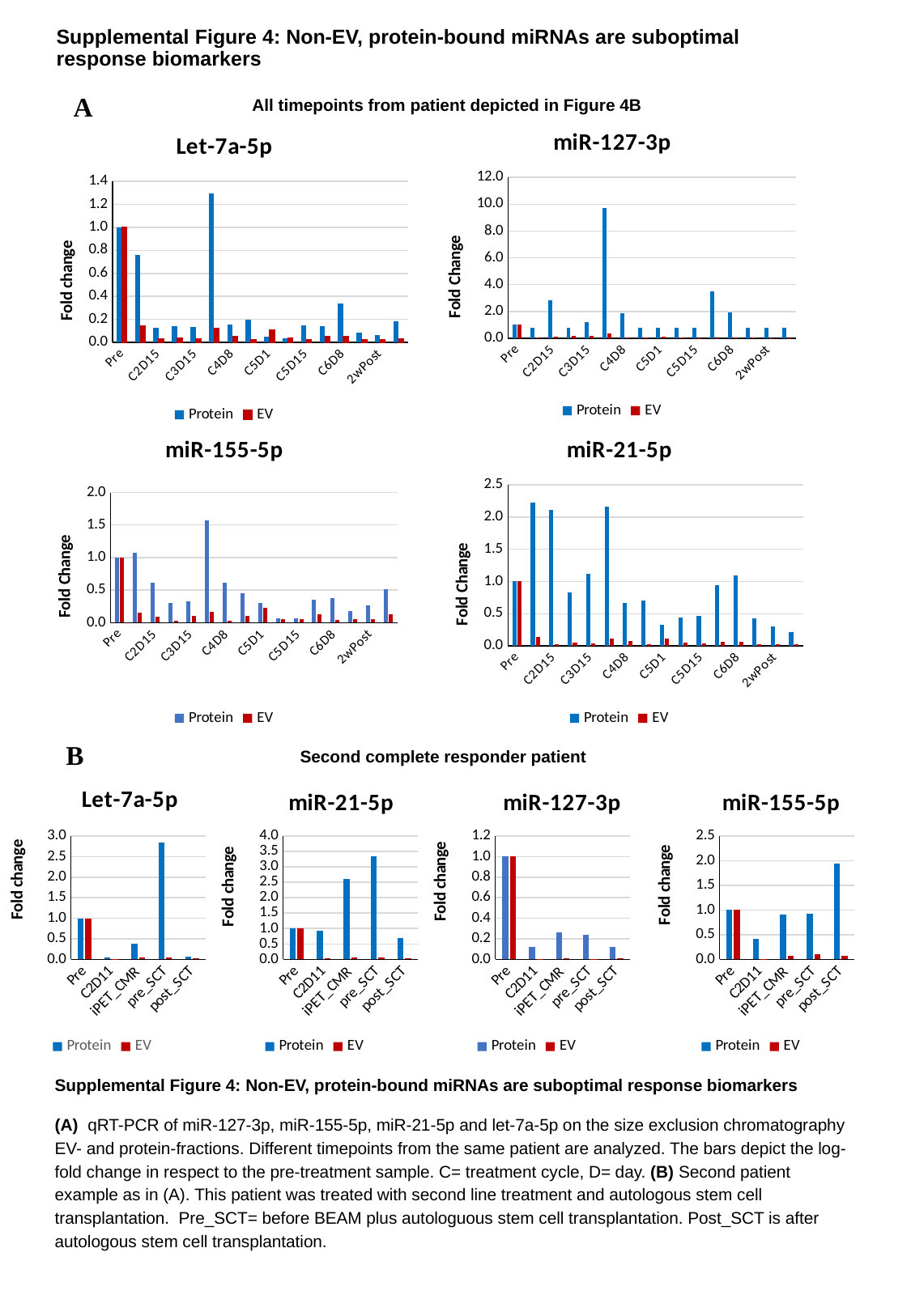
What are the two legend entries in the miR-155-5p chart in panel A? Protein and EV How many timepoint categories are shown on the x axis of the miR-127-3p chart in panel B? 5 In the Let-7a-5p chart in panel B, what is the Protein value at Pre? 1.0 In the miR-21-5p chart in panel B, which timepoint has the highest Protein value? pre_SCT In the miR-21-5p chart in panel B, is the Protein value at pre_SCT greater or less than 3.0? greater In the miR-21-5p chart in panel A, which is larger at C2D15, the Protein value or the EV value? Protein How many series does the legend of the miR-127-3p chart in panel A list? 2 In the miR-155-5p chart in panel B, which timepoint has the highest Protein value? post_SCT In the Let-7a-5p chart in panel B, is the Protein value at pre_SCT greater or less than 2.5? greater What kind of chart is the Let-7a-5p chart in panel A? bar chart